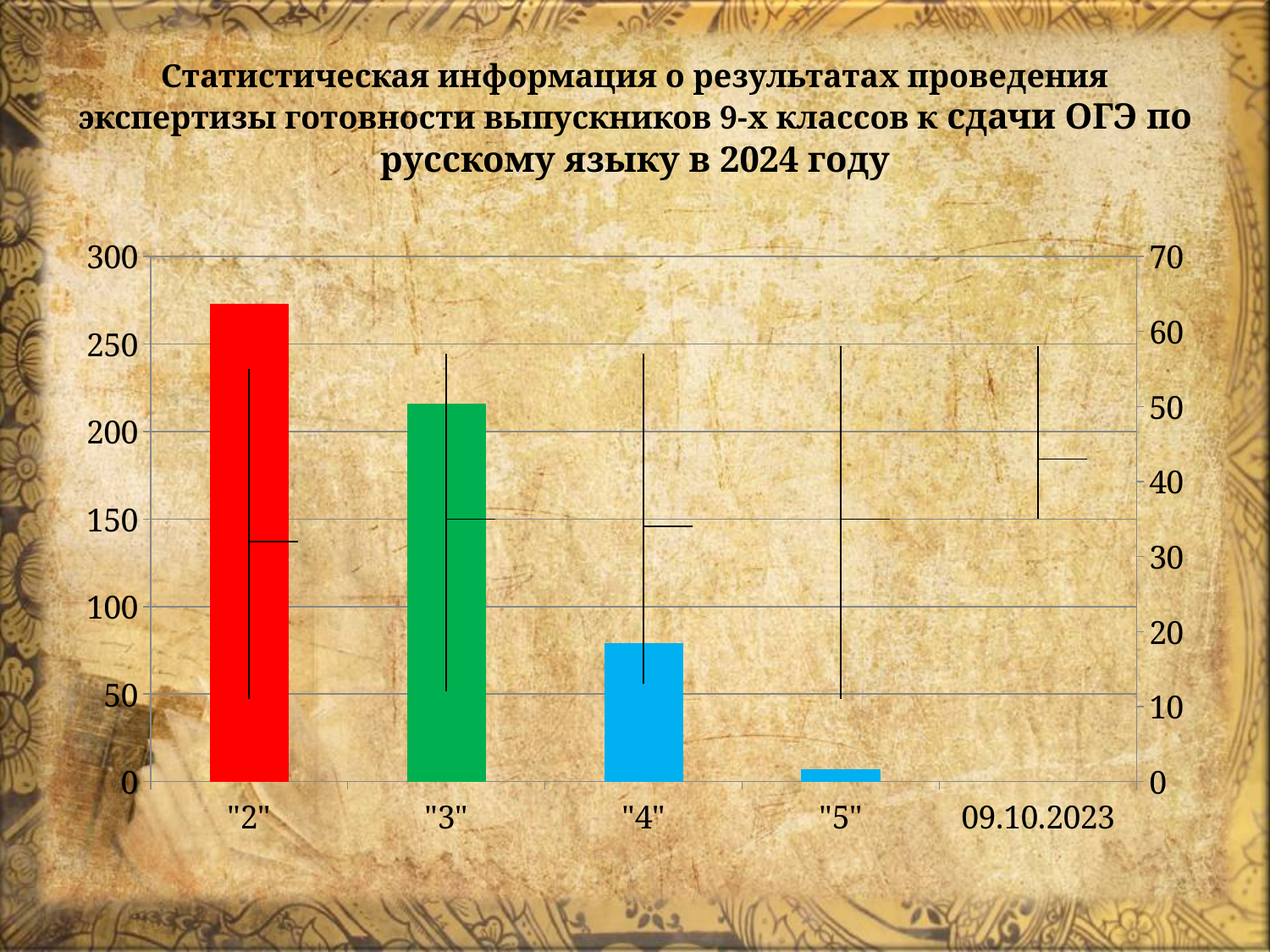
Is the value for "3" greater or less than 200 on the left axis? greater Is the value for "5" greater or less than 50 on the left axis? less Which of the plotted bars is the shortest? "5" Do the bar values rise or fall going from "2" to "5" along the x axis? fall How many categories are labelled on the x axis? 5 What colour is the bar for "2"? red What kind of chart is shown on the slide? bar chart Is the value for "4" greater or less than 100 on the left axis? less Which is larger, the bar for "3" or the bar for "4"? "3" Which is larger, the bar for "2" or the bar for "3"? "2" Which category has the tallest bar? "2"